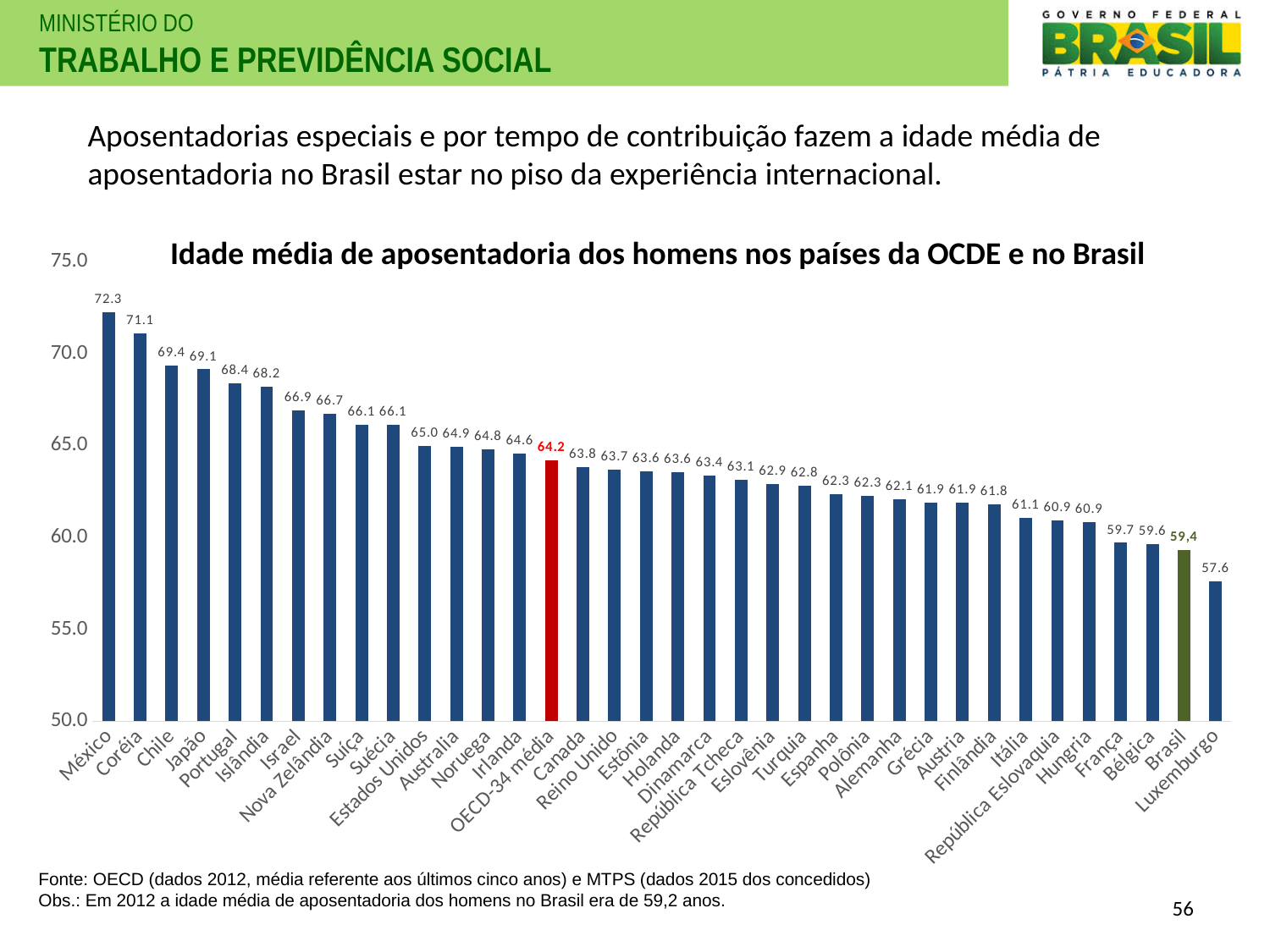
Which country has the lowest value in the chart? Luxemburgo How many bars are plotted in the chart? 36 What is the value shown for Brasil? 59,4 Which has a higher value, Chile or Japão? Chile Which country has the highest average retirement age in the chart? México Do the values rise or fall from left to right along the x axis? Fall What is the difference between the values for México and Coréia? 1.2 What kind of chart is shown on the slide? Bar chart What is the value for México? 72.3 What is the value for Luxemburgo? 57.6 What is the difference between the OECD-34 média value and the Brasil value? 4.8 What is the value for OECD-34 média? 64.2